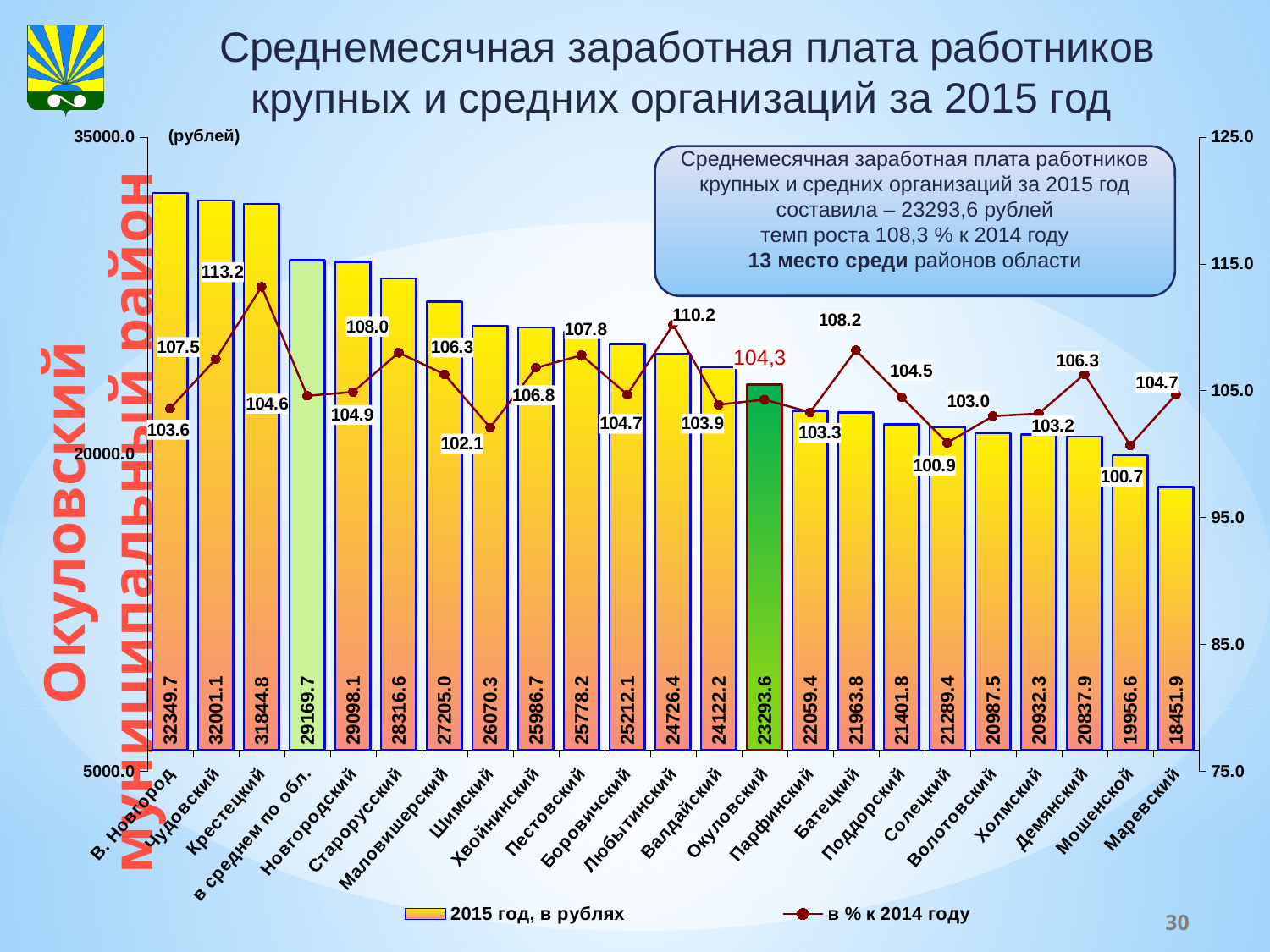
What is the value of the 'в % к 2014 году' line for Крестецкий? 113.2 Do the 2015 wage bars rise or fall from left to right along the x axis? Fall Which has the larger 'в % к 2014 году' value: Любытинский or Валдайский? Любытинский Which category has the lowest 2015 wage bar? Маревский Which category has the lowest value on the 'в % к 2014 году' line? Мошенской Which category has the highest 2015 wage bar? В. Новгород What is the 2015 average monthly wage (in rubles) shown for Окуловский? 23293.6 How many series does the legend list? 2 What is the difference between the 2015 wage bars for В. Новгород and Маревский? 13897.8 What kind of chart is this? Combined bar and line chart What is the 2015 wage value shown for 'в среднем по обл.'? 29169.7 How many categories are shown on the x axis? 23